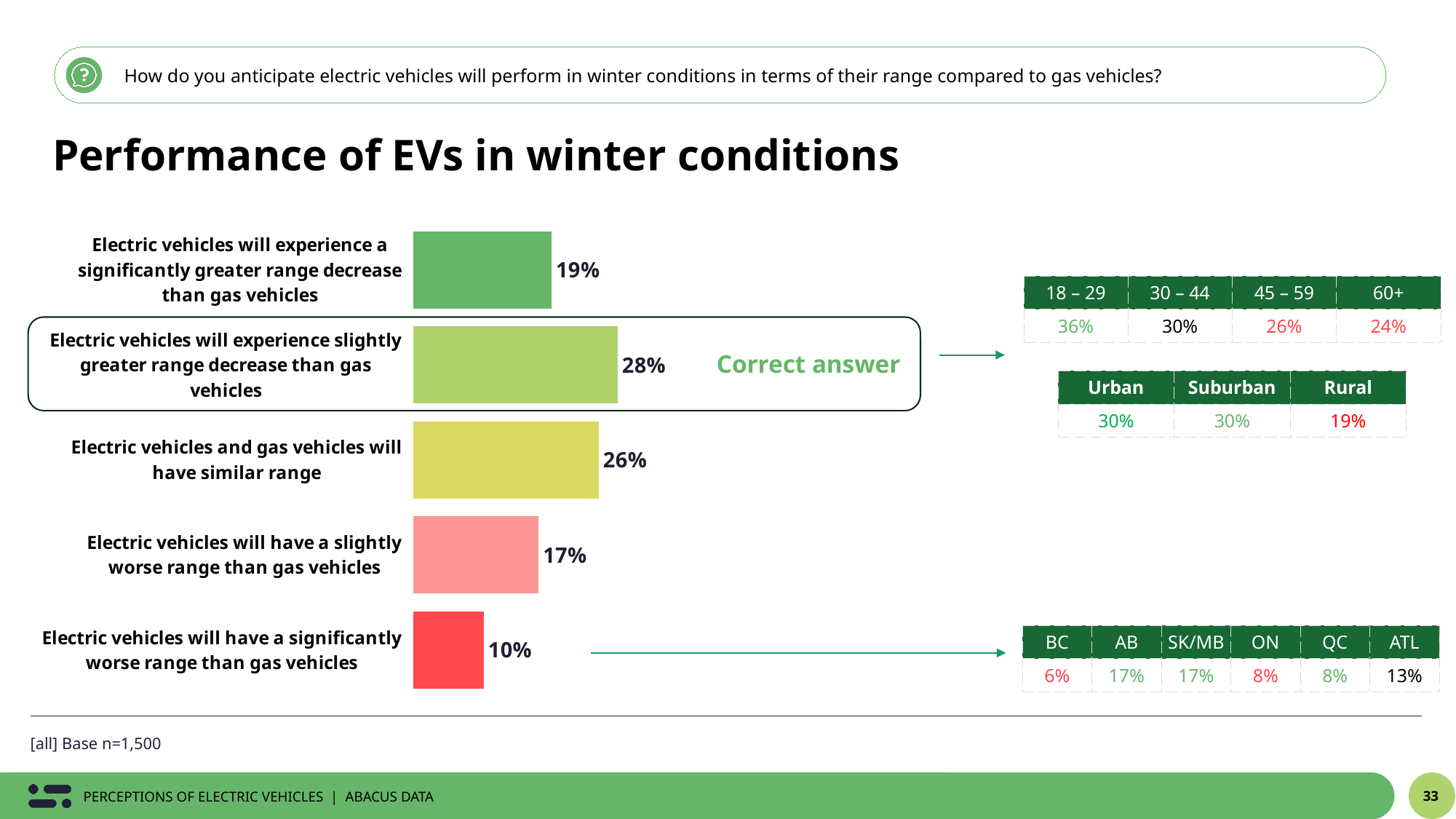
What is the combined percentage of respondents who said EVs will have a slightly worse or significantly worse range than gas vehicles? 27% How many response options are shown in the bar chart? 5 What type of chart is used to show the response percentages? Bar chart What percentage of respondents said electric vehicles and gas vehicles will have similar range? 26% Which response option has the highest percentage? Electric vehicles will experience slightly greater range decrease than gas vehicles What is the difference in percentage points between 'significantly greater range decrease' (19%) and 'significantly worse range' (10%)? 9 percentage points What is the base sample size noted on the slide? n=1,500 Which is larger: the percentage for 'similar range' or the percentage for 'slightly worse range'? Similar range (26%) Which response option has the lowest percentage? Electric vehicles will have a significantly worse range than gas vehicles What percentage of respondents said electric vehicles will have a significantly worse range than gas vehicles? 10% Which response option is marked as the correct answer? Electric vehicles will experience slightly greater range decrease than gas vehicles What percentage of respondents said electric vehicles will experience slightly greater range decrease than gas vehicles? 28%